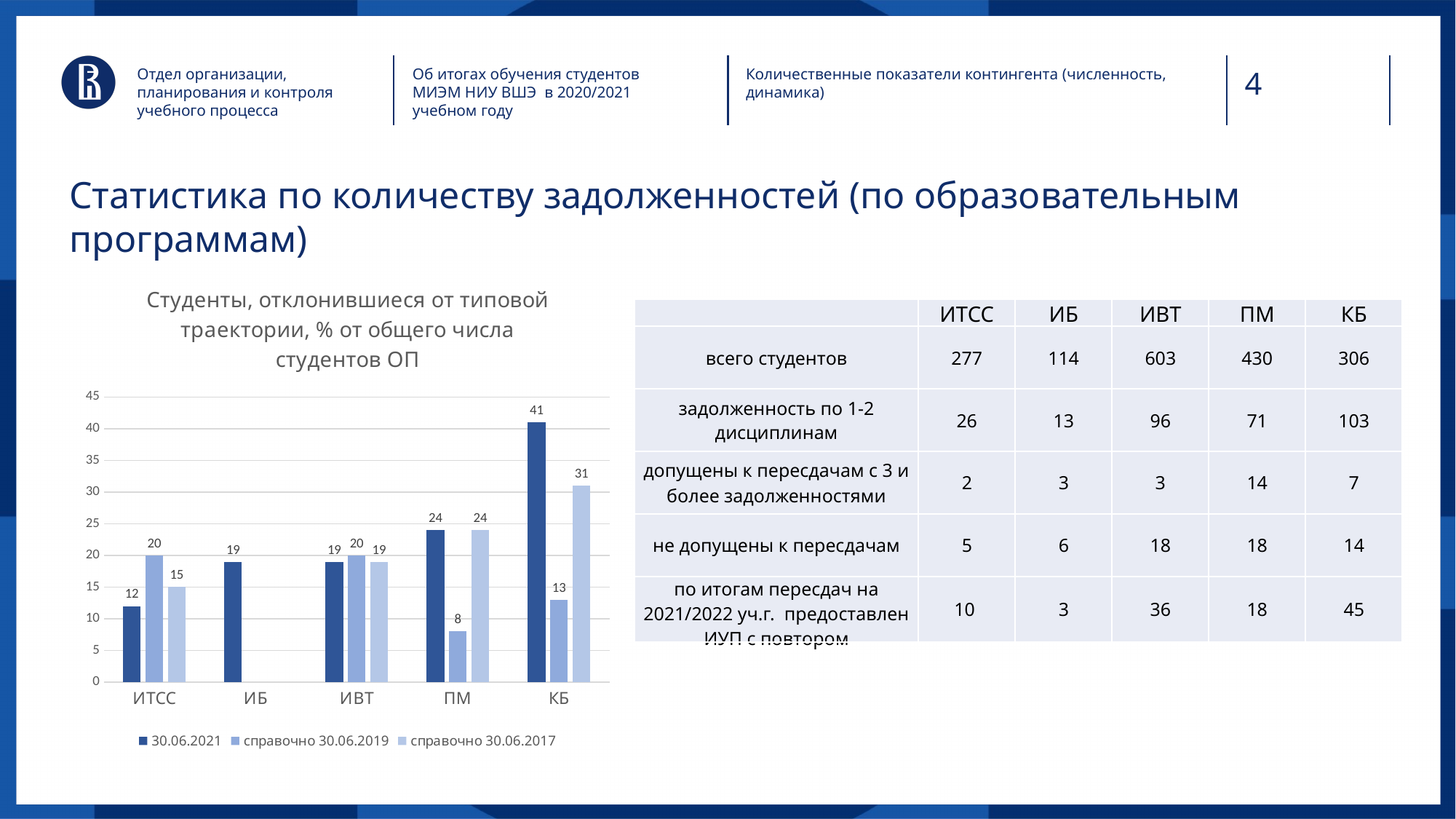
Is the 30.06.2021 value for КБ greater or less than 35? greater How many series does the chart legend list? 3 What is the value for ПМ in the справочно 30.06.2017 series? 24 How many categories are shown on the x axis of the chart? 5 What is the title of the chart? Студенты, отклонившиеся от типовой траектории, % от общего числа студентов ОП What is the value for КБ in the 30.06.2021 series? 41 What is the difference between the 30.06.2021 value for КБ and the 30.06.2021 value for ИТСС? 29 Which is larger: the справочно 30.06.2017 value for КБ or the справочно 30.06.2019 value for КБ? справочно 30.06.2017 What type of chart is shown on the slide? bar chart Which category has the highest value in the 30.06.2021 series? КБ What is the value for ИТСС in the справочно 30.06.2019 series? 20 Which category has the lowest value in the справочно 30.06.2019 series? ПМ